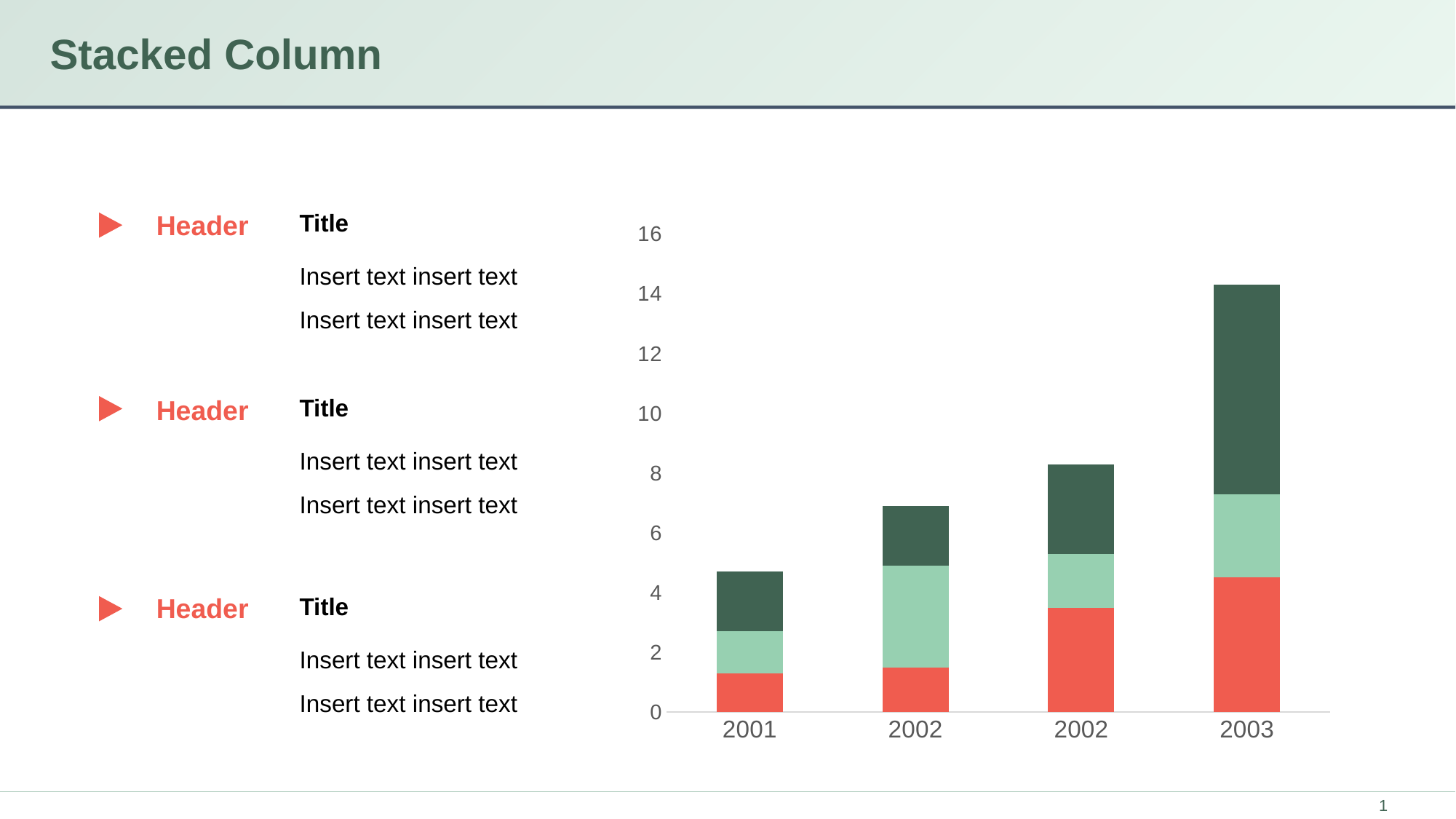
Which bar has the larger total, the second bar from the left or the third bar from the left? The third bar from the left What colour is the bottom segment of each bar? Red Do the bar totals rise or fall from left to right along the x axis? Rise Is the total value of the 2001 bar greater or less than 6? less How many bars are plotted in the chart? 4 Is the total value of the third bar from the left (labelled 2002) greater or less than 10? less Is the total value of the 2003 bar greater or less than 12? greater Which bar has the highest total value? 2003 How many stacked segments does each bar contain? 3 Which bar has the lowest total value? 2001 What kind of chart is shown on the slide? Stacked bar chart Which bar has the larger total, 2001 or 2003? 2003